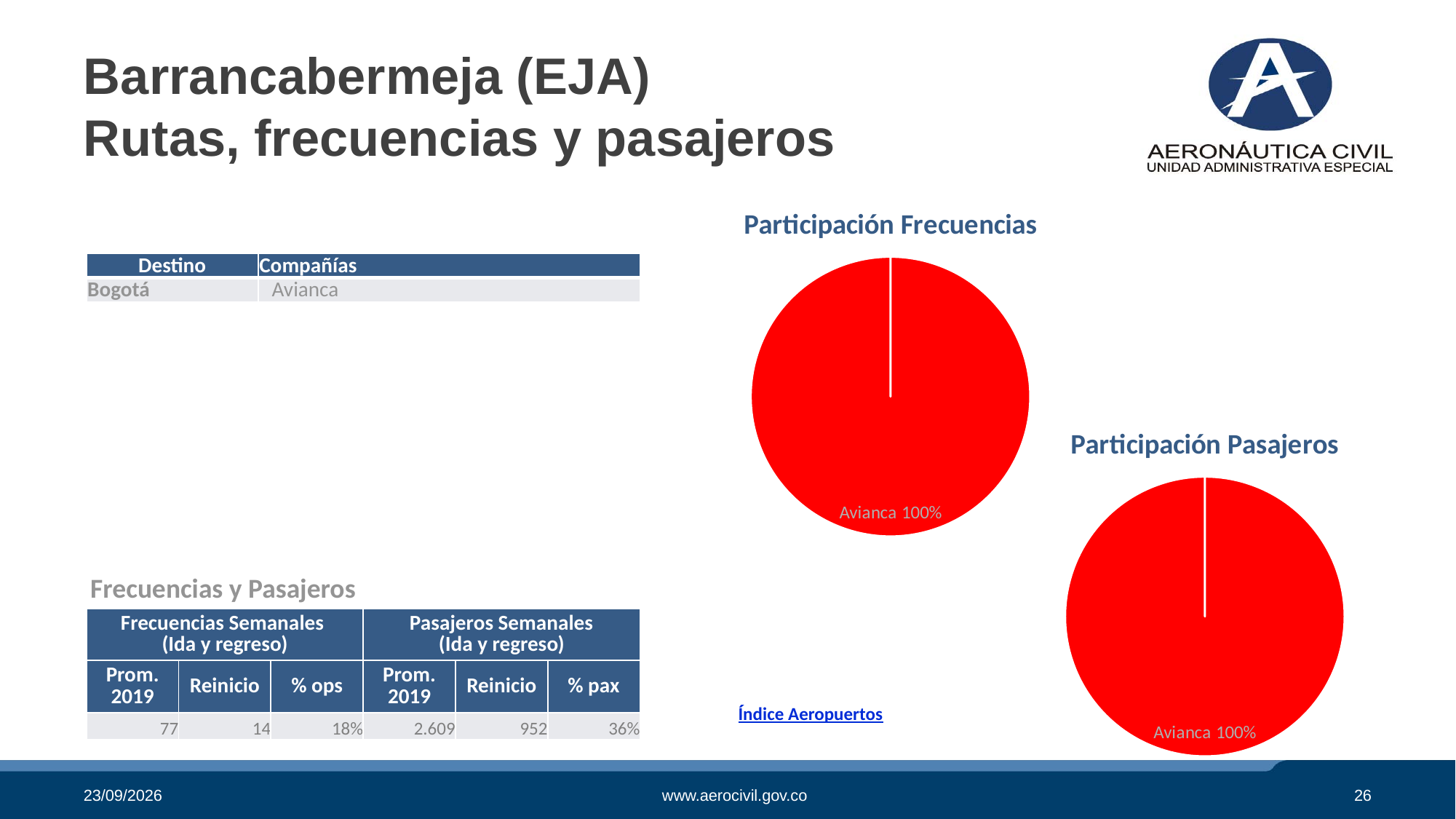
How many slices does the 'Participación Frecuencias' pie chart have? 1 How many slices does the 'Participación Pasajeros' pie chart have? 1 What is the title of the pie chart on the upper part of the slide? Participación Frecuencias What colour is the Avianca slice in the 'Participación Pasajeros' chart? Red In the 'Participación Frecuencias' chart, what share does Avianca have? 100% What kind of chart is 'Participación Frecuencias'? Pie chart What kind of chart is 'Participación Pasajeros'? Pie chart Which company is shown in the 'Participación Frecuencias' chart? Avianca Which company is shown in the 'Participación Pasajeros' chart? Avianca In the 'Participación Pasajeros' chart, what share does Avianca have? 100%